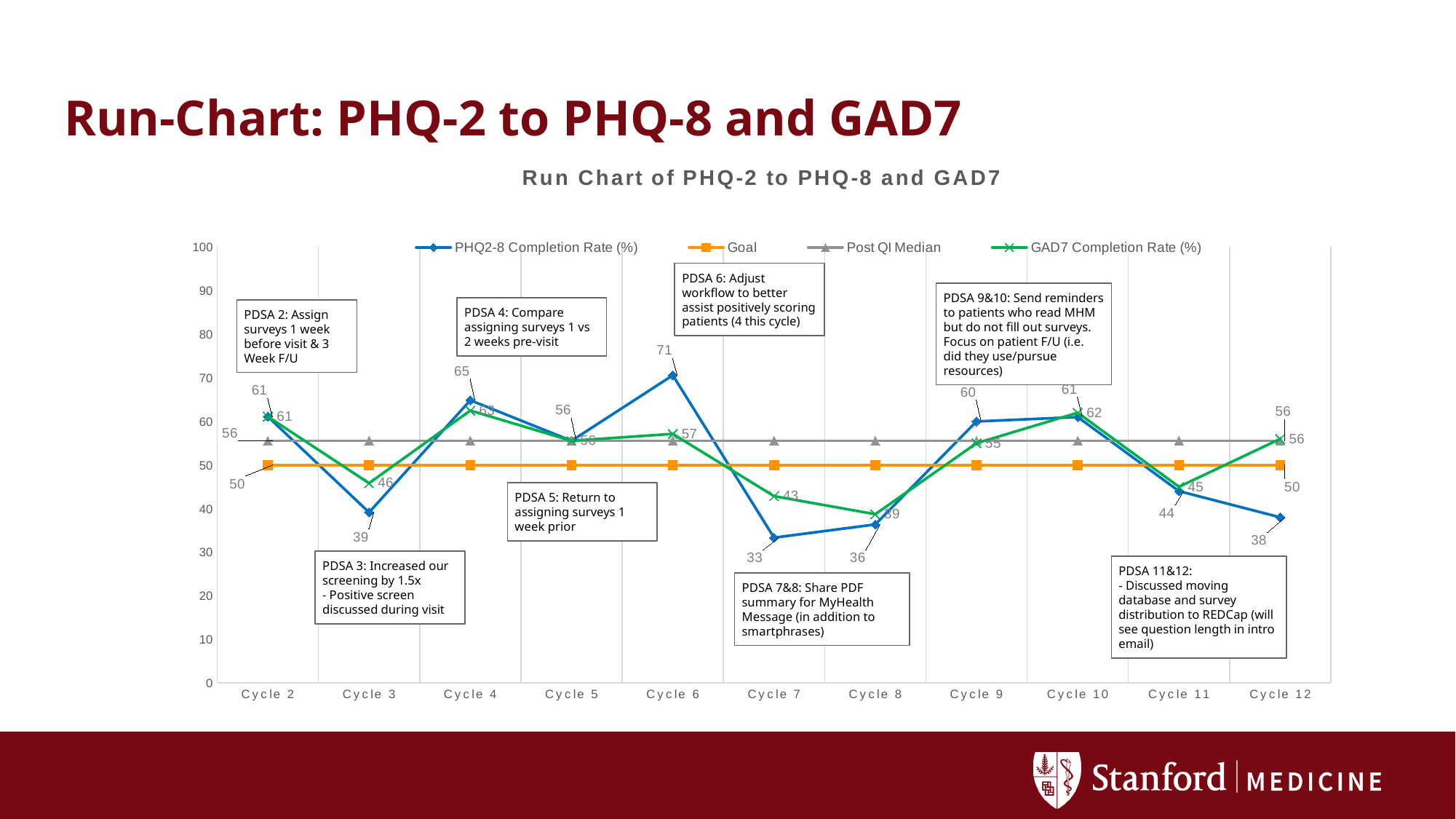
What is the PHQ2-8 Completion Rate (%) for Cycle 6? 71 What is the GAD7 Completion Rate (%) for Cycle 3? 46 What is the difference between the PHQ2-8 Completion Rate (%) in Cycle 6 and in Cycle 7? 38 Does the PHQ2-8 Completion Rate (%) rise or fall from Cycle 10 to Cycle 12? Fall What type of chart is shown on the slide? Line chart What is the value of the Goal line? 50 In which cycle is the GAD7 Completion Rate (%) highest? Cycle 4 Which is larger in Cycle 8: the PHQ2-8 Completion Rate (%) or the GAD7 Completion Rate (%)? GAD7 Completion Rate (%) How many series does the legend list? 4 How many cycles are shown on the x axis? 11 In which cycle is the PHQ2-8 Completion Rate (%) lowest? Cycle 7 What is the value of the Post QI Median line? 56